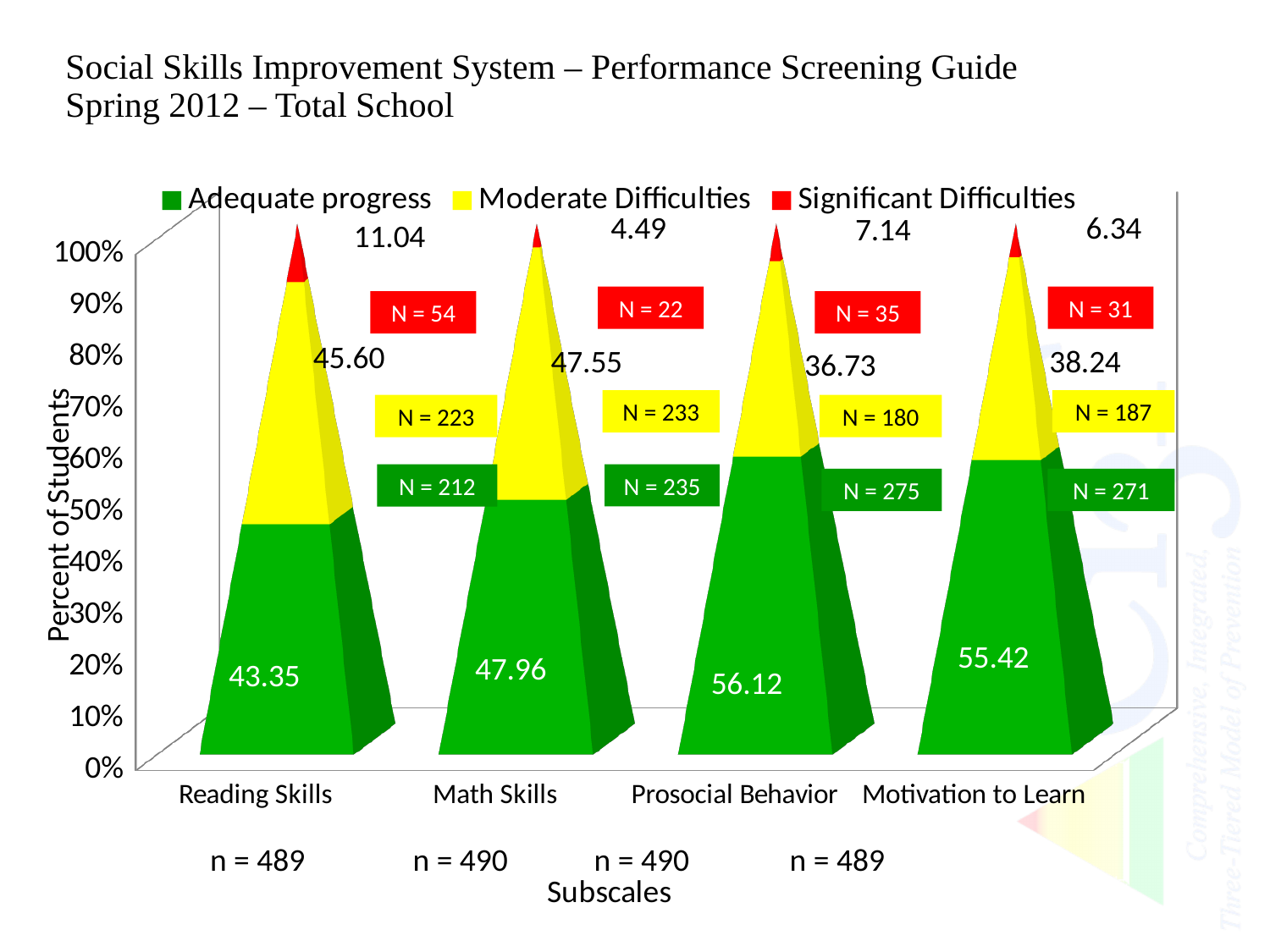
How many series does the legend list? 3 How many subscales are shown on the x axis? 4 What is the Adequate progress value for Prosocial Behavior? 56.12 Which subscale has the highest Adequate progress value? Prosocial Behavior What is the Moderate Difficulties value for Math Skills? 47.55 Which has the larger Adequate progress value, Reading Skills or Math Skills? Math Skills What is the difference between the Moderate Difficulties values for Reading Skills and Motivation to Learn? 7.36 What colour represents Significant Difficulties in the legend? Red What is the Significant Difficulties value for Reading Skills? 11.04 Which subscale has the lowest Significant Difficulties value? Math Skills What kind of chart is shown on the slide? Stacked bar chart What is the N value shown for Significant Difficulties in Prosocial Behavior? N = 35